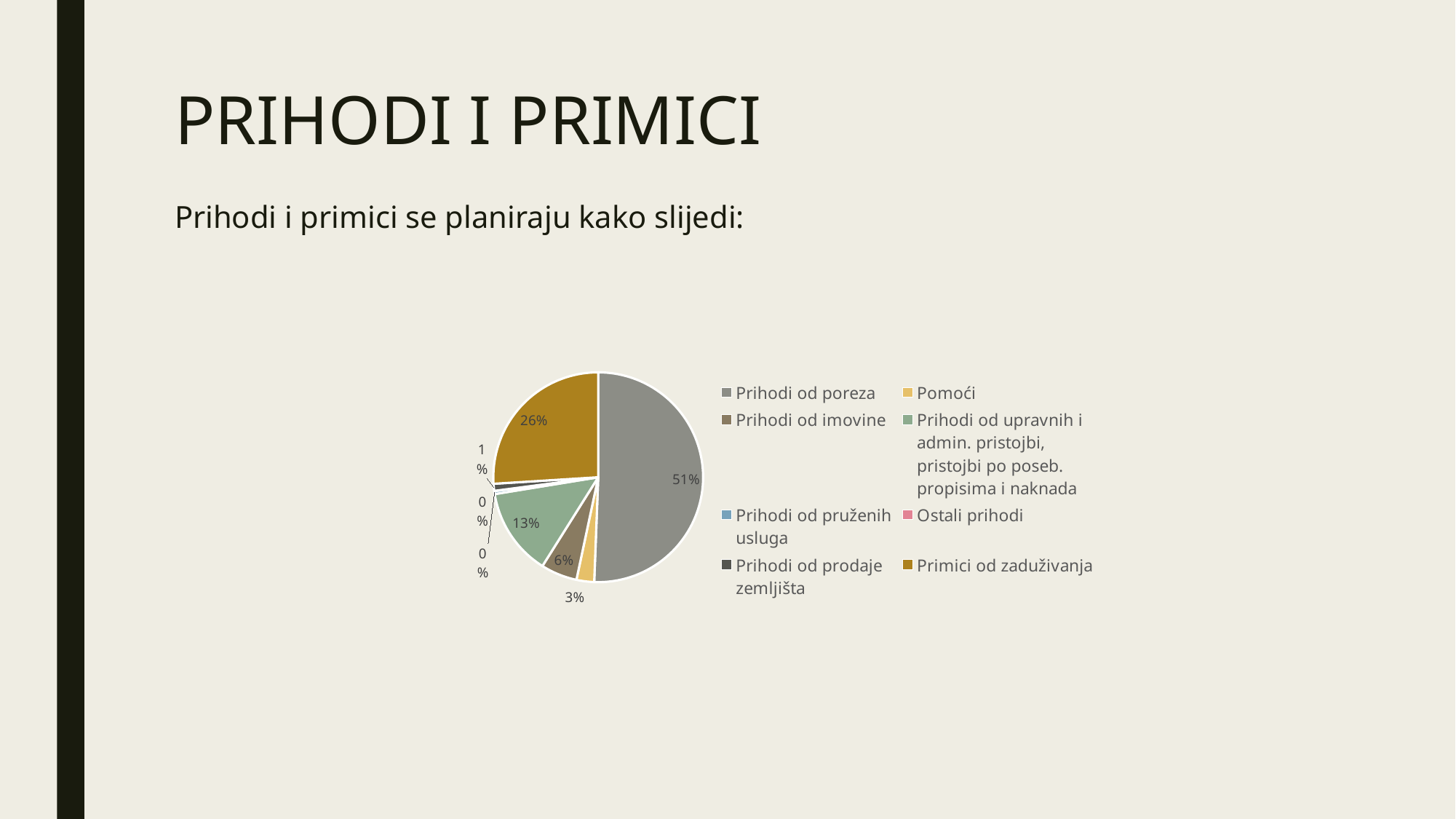
What share of the pie does Primici od zaduživanja take? 26% Which category has the largest slice of the pie? Prihodi od poreza What kind of chart is shown on the slide? pie chart What share of the pie does Prihodi od prodaje zemljišta take? 1% What share of the pie does Prihodi od upravnih i admin. pristojbi, pristojbi po poseb. propisima i naknada take? 13% What is the difference in percentage points between the Prihodi od poreza slice and the Primici od zaduživanja slice? 25 How many categories does the legend of the pie chart list? 8 Which is larger, the slice for Primici od zaduživanja or the slice for Prihodi od imovine? Primici od zaduživanja What colour is the slice for Primici od zaduživanja? gold